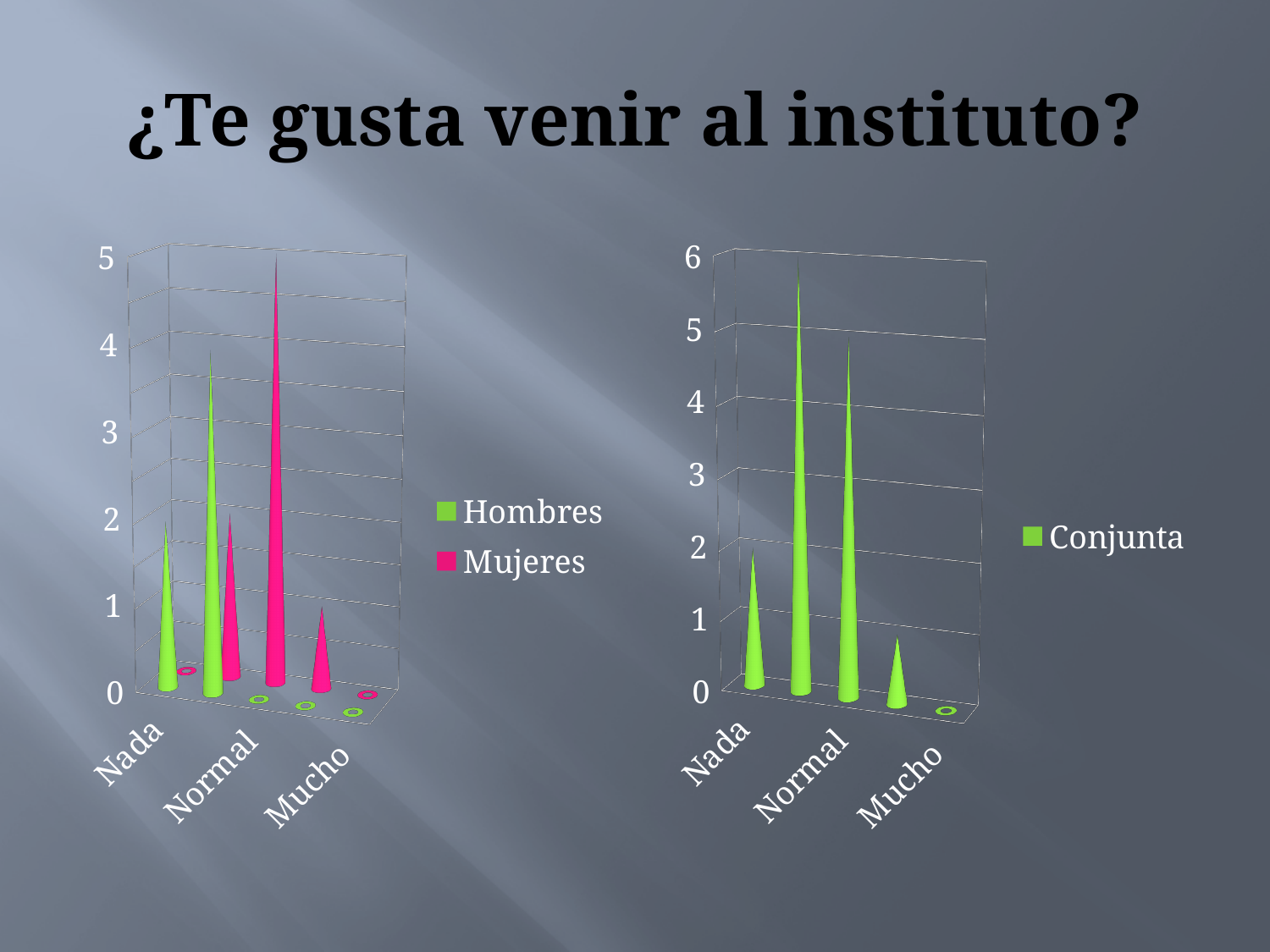
In the right chart, is the Conjunta value for Nada greater or less than 3? less How many series does the legend of the left chart list? 2 In the left chart, is the Hombres value for Nada greater or less than 1? greater What is the title of the slide containing the charts? ¿Te gusta venir al instituto? In the left chart, is the Hombres value for Nada greater or less than 3? less What kind of chart is the left chart on the slide? bar chart What kind of chart is the right chart on the slide? bar chart What is the name of the series in the right chart's legend? Conjunta How many category labels are shown on the x axis of the right chart? 3 What are the series names in the legend of the left chart? Hombres, Mujeres How many series does the legend of the right chart list? 1